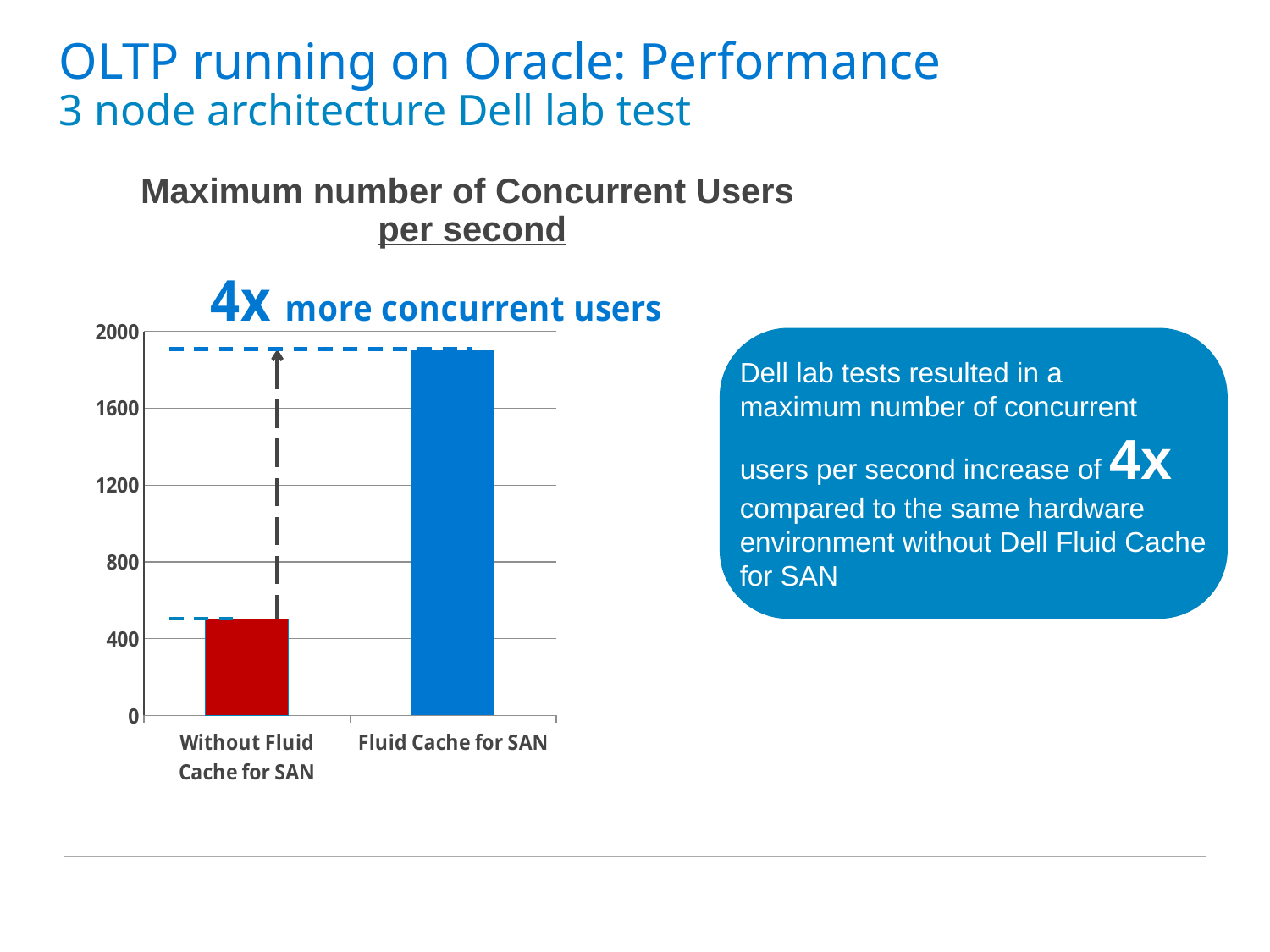
How many categories are plotted in the chart? 2 Is the value for Without Fluid Cache for SAN greater or less than 400? greater Is the value for Fluid Cache for SAN greater or less than 1600? greater Which category has the highest value in the chart? Fluid Cache for SAN What colour is the bar for Without Fluid Cache for SAN? red Which is larger: the value for Without Fluid Cache for SAN or the value for Fluid Cache for SAN? Fluid Cache for SAN Is the value for Fluid Cache for SAN greater or less than 2000? less Which category has the lowest value in the chart? Without Fluid Cache for SAN What is the highest value shown on the vertical axis of the chart? 2000 What kind of chart is shown on the slide? bar chart What is the title of the chart? Maximum number of Concurrent Users per second